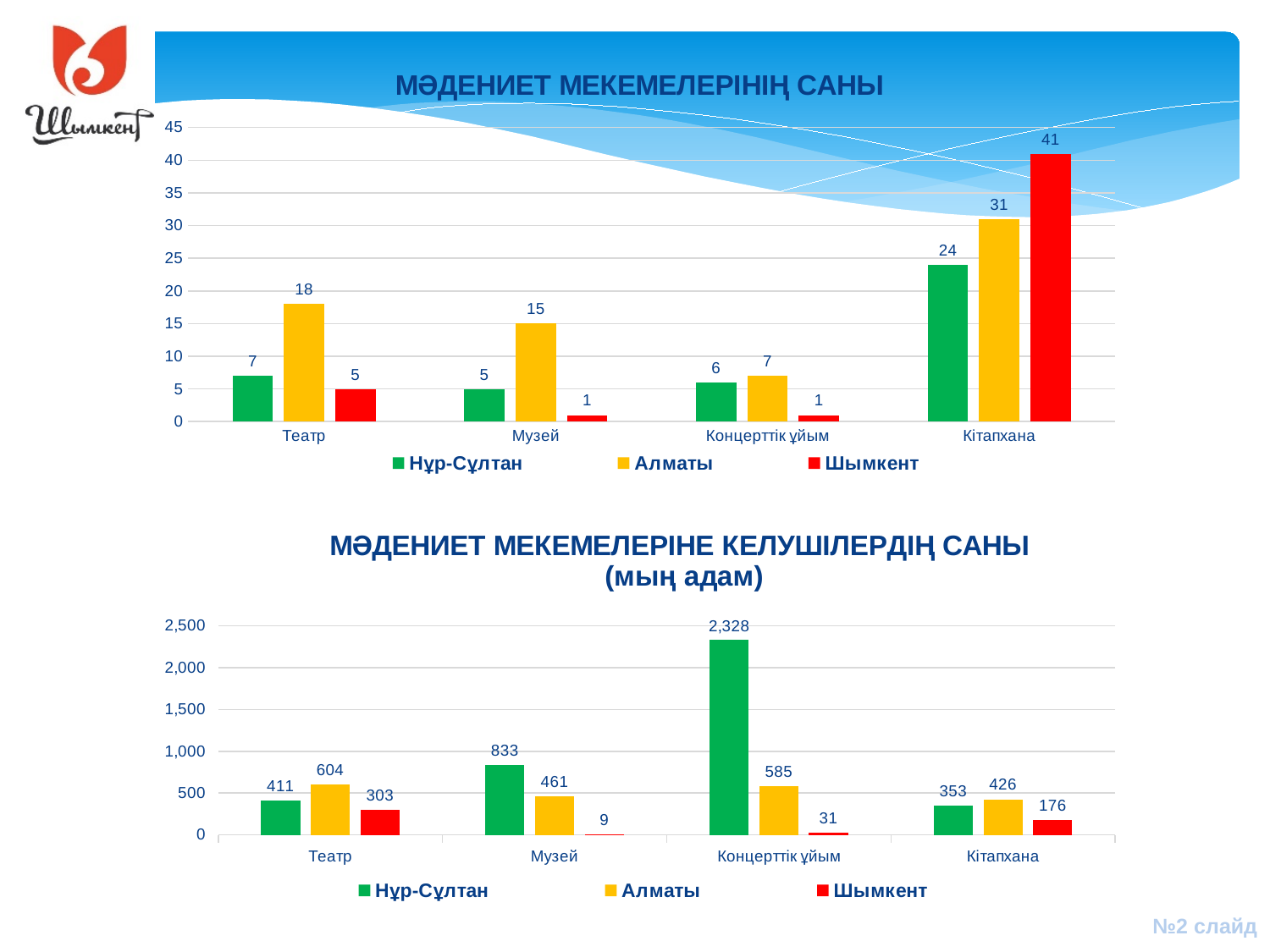
In the top chart (МӘДЕНИЕТ МЕКЕМЕЛЕРІНІҢ САНЫ), what is the value for Алматы in the Театр category? 18 In the top chart (МӘДЕНИЕТ МЕКЕМЕЛЕРІНІҢ САНЫ), what is the difference between the Алматы and Нұр-Сұлтан values for Музей? 10 In the top chart (МӘДЕНИЕТ МЕКЕМЕЛЕРІНІҢ САНЫ), which category has the highest value for Нұр-Сұлтан? Кітапхана In the bottom chart (МӘДЕНИЕТ МЕКЕМЕЛЕРІНЕ КЕЛУШІЛЕРДІҢ САНЫ), which category has the lowest value for Шымкент? Музей In the bottom chart (МӘДЕНИЕТ МЕКЕМЕЛЕРІНЕ КЕЛУШІЛЕРДІҢ САНЫ), what is the value for Нұр-Сұлтан in the Концерттік ұйым category? 2,328 What kind of chart is the bottom chart (МӘДЕНИЕТ МЕКЕМЕЛЕРІНЕ КЕЛУШІЛЕРДІҢ САНЫ)? Bar chart In the top chart (МӘДЕНИЕТ МЕКЕМЕЛЕРІНІҢ САНЫ), what is the value for Шымкент in the Кітапхана category? 41 In the top chart (МӘДЕНИЕТ МЕКЕМЕЛЕРІНІҢ САНЫ), how many series does the legend list? 3 In the bottom chart (МӘДЕНИЕТ МЕКЕМЕЛЕРІНЕ КЕЛУШІЛЕРДІҢ САНЫ), which is larger for Театр: Нұр-Сұлтан or Алматы? Алматы In the bottom chart (МӘДЕНИЕТ МЕКЕМЕЛЕРІНЕ КЕЛУШІЛЕРДІҢ САНЫ), what is the value for Шымкент in the Музей category? 9 In the top chart (МӘДЕНИЕТ МЕКЕМЕЛЕРІНІҢ САНЫ), how many categories are shown on the x axis? 4 In the bottom chart (МӘДЕНИЕТ МЕКЕМЕЛЕРІНЕ КЕЛУШІЛЕРДІҢ САНЫ), what is the difference between the Алматы and Шымкент values for Кітапхана? 250